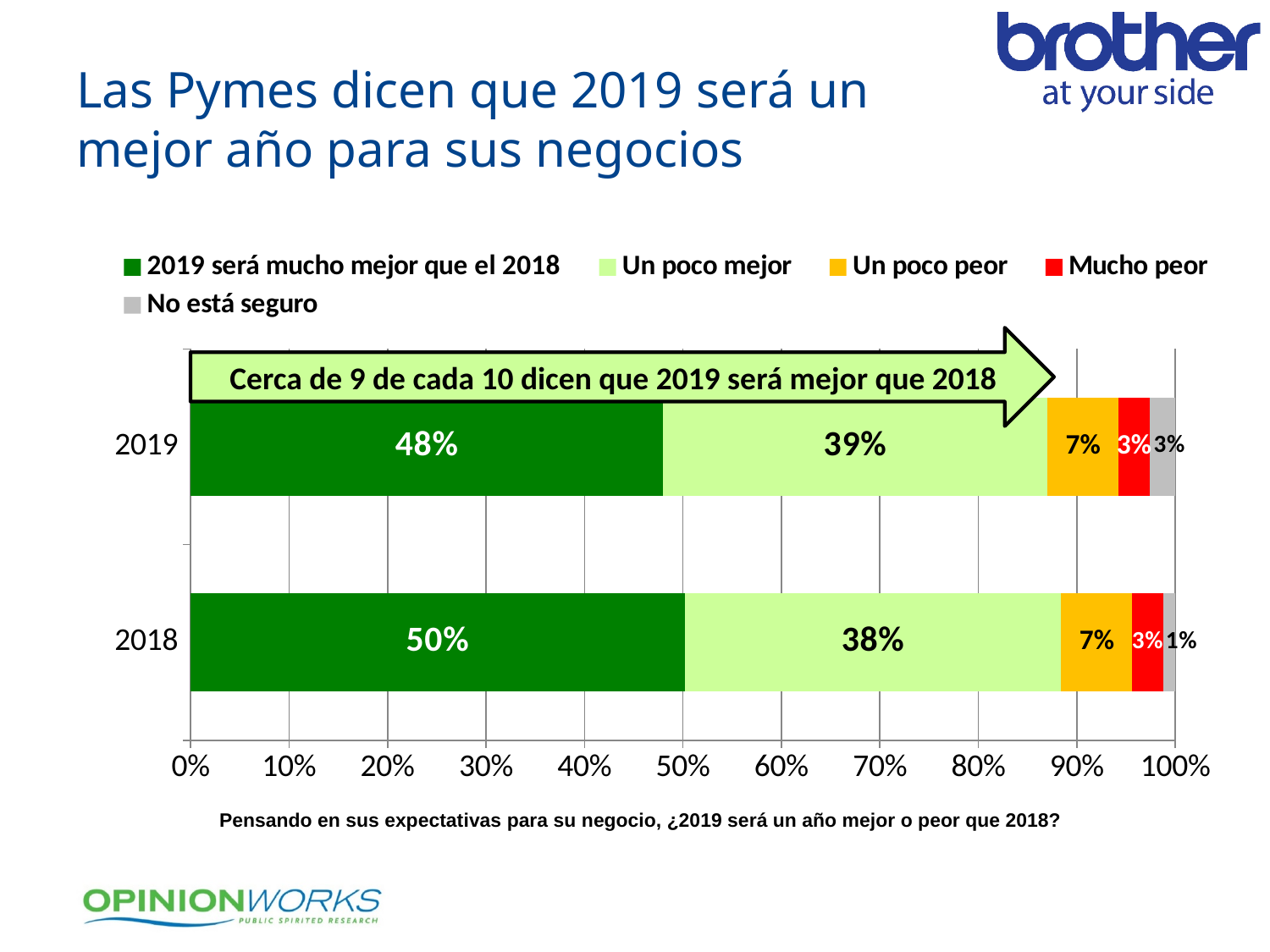
What is the difference between the "2019 será mucho mejor que el 2018" values for 2018 and 2019? 2% What is the value for "Un poco mejor" in the 2018 bar? 38% What is the value for "No está seguro" in the 2018 bar? 1% What kind of chart is shown on the slide? Stacked bar chart Which segment is the smallest in the 2018 bar? No está seguro What is the value for "Un poco peor" in the 2019 bar? 7% How many bars (years) are shown in the chart? 2 What colour represents "Mucho peor" in the chart? Red How many series does the legend list? 5 Which segment is the largest in the 2018 bar? 2019 será mucho mejor que el 2018 Which year has the larger "Un poco mejor" value, 2019 or 2018? 2019 What percentage of respondents said 2019 will be much better than 2018 ("2019 será mucho mejor que el 2018") in the 2019 bar? 48%